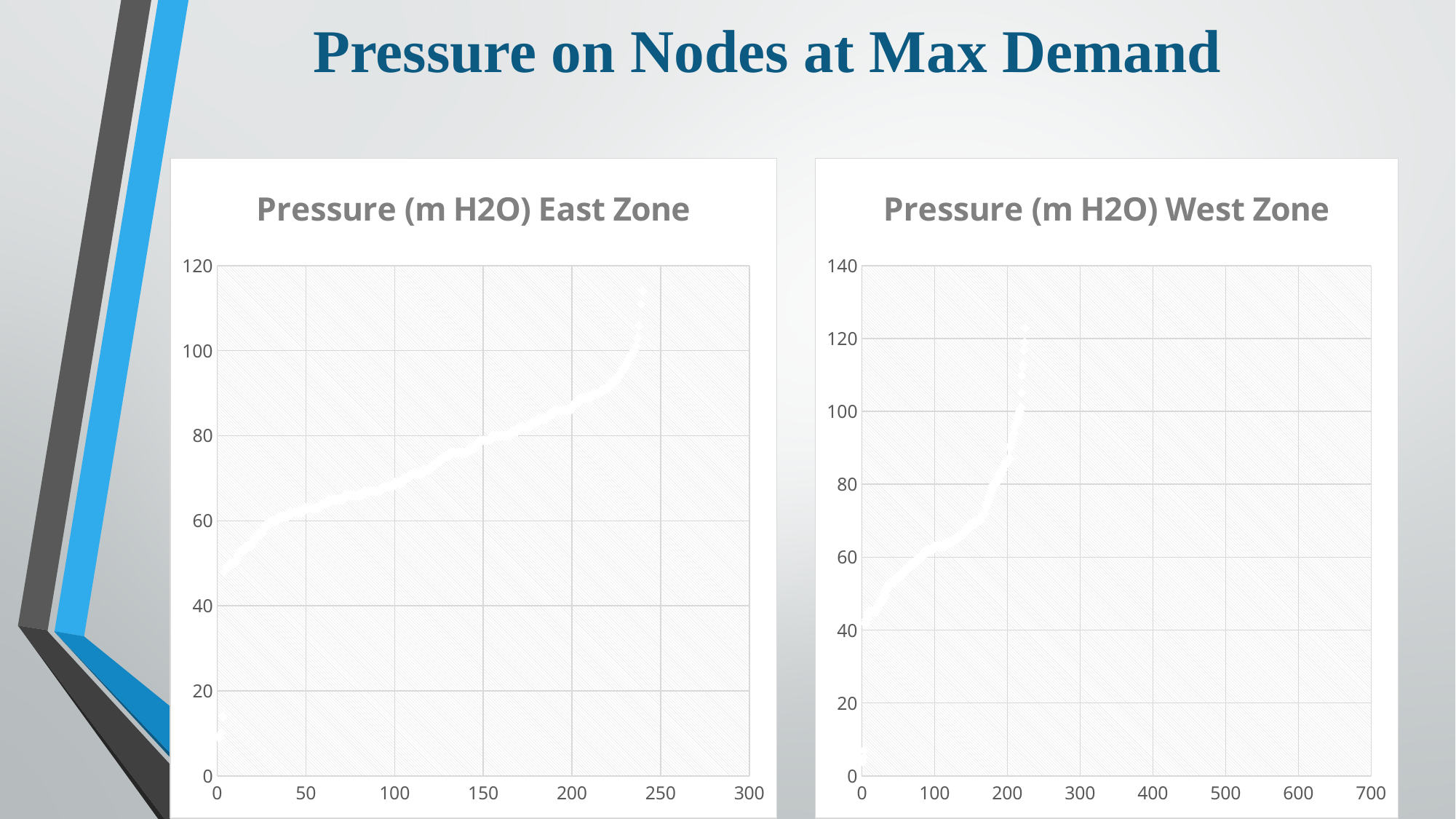
What kind of chart is the Pressure (m H2O) West Zone chart? scatter chart In the Pressure (m H2O) West Zone chart, is the value at x = 50 greater or less than 60? less What kind of chart is the Pressure (m H2O) East Zone chart? scatter chart What is the maximum value shown on the x axis of the Pressure (m H2O) East Zone chart? 300 In the Pressure (m H2O) East Zone chart, is the value at x = 200 greater or less than 80? greater In the Pressure (m H2O) West Zone chart, is the highest plotted value greater or less than 100? greater In the Pressure (m H2O) East Zone chart, do the values rise or fall as you move along the x axis? rise In the Pressure (m H2O) West Zone chart, do the values rise or fall as you move along the x axis? rise What is the maximum value shown on the y axis of the Pressure (m H2O) West Zone chart? 140